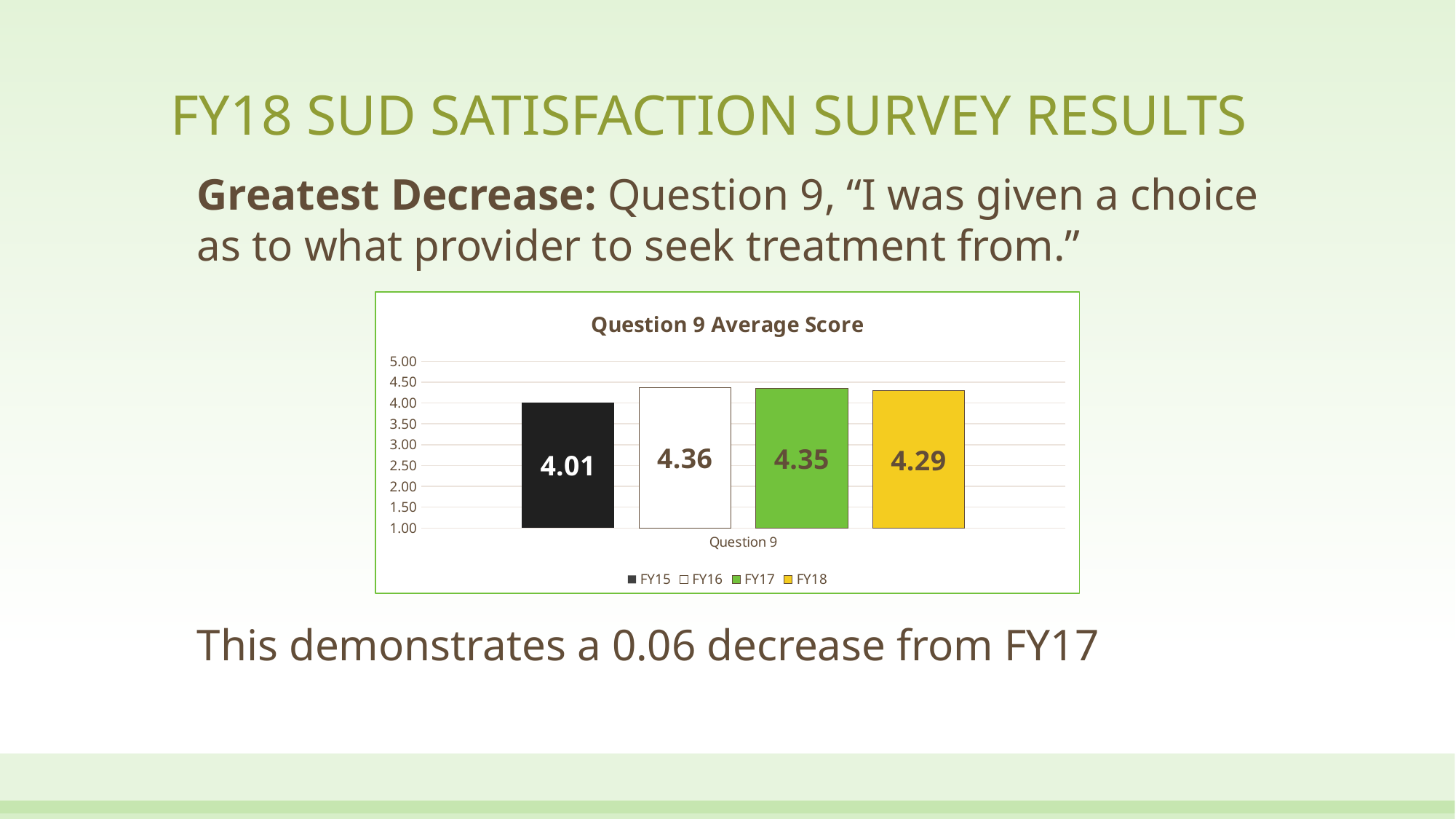
What is the title of the chart? Question 9 Average Score What is the FY18 average score for Question 9? 4.29 What is the FY17 average score for Question 9? 4.35 What is the difference between the FY16 and FY15 average scores for Question 9? 0.35 How many series does the legend list? 4 What kind of chart is shown on the slide? bar chart Which is larger, the FY15 score or the FY18 score for Question 9? FY18 What is the difference between the FY17 and FY18 average scores for Question 9? 0.06 What is the FY16 average score for Question 9? 4.36 Which fiscal year has the lowest average score for Question 9? FY15 Is the FY15 average score for Question 9 greater or less than 4.50? less What is the FY15 average score for Question 9? 4.01